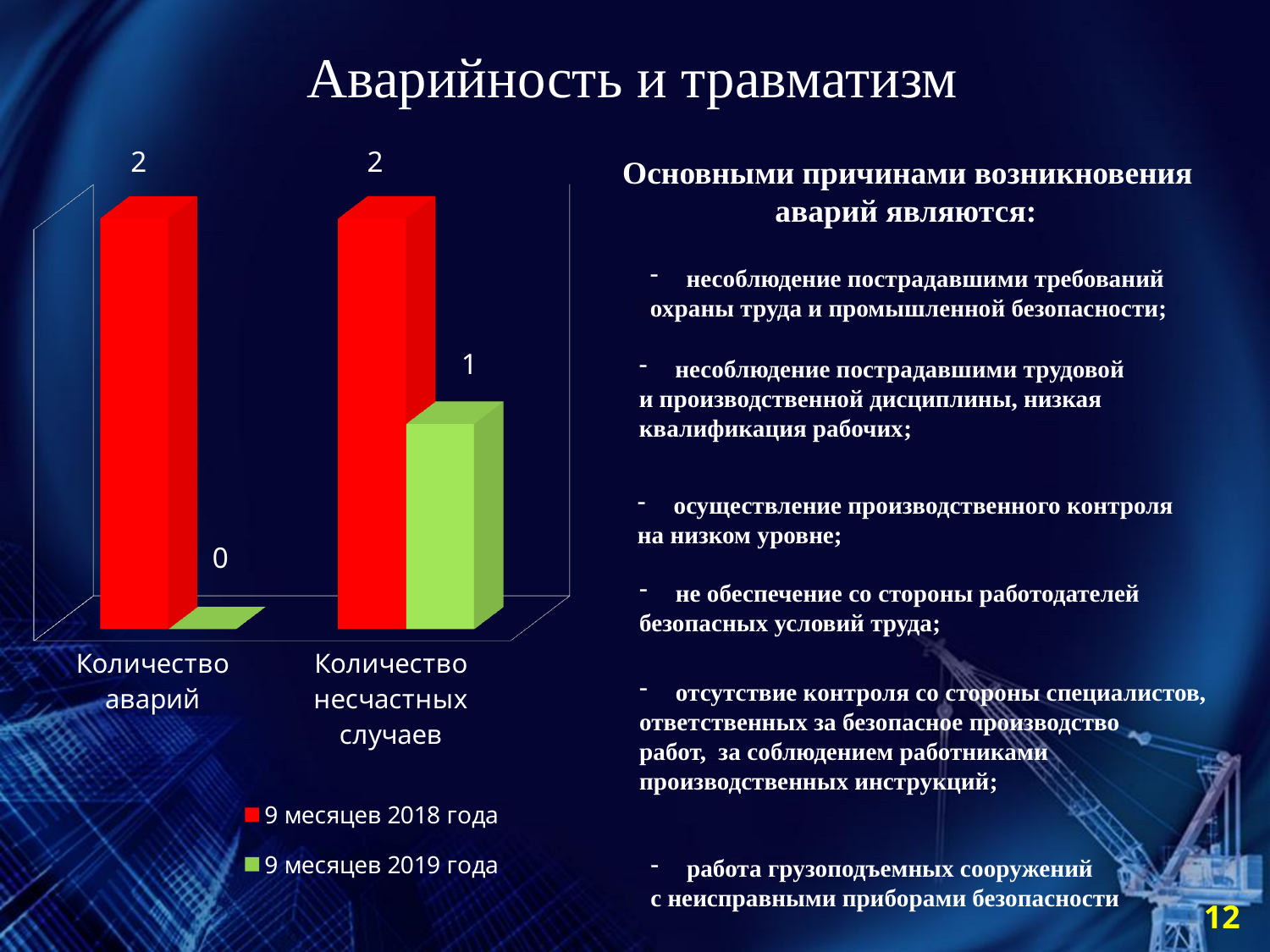
What is the value for "Количество несчастных случаев" in the "9 месяцев 2019 года" series? 1 Which colour represents the "9 месяцев 2019 года" series in the chart? Green What is the difference between the 2018 and 2019 values for "Количество несчастных случаев"? 1 What kind of chart is shown on the slide? Bar chart What is the difference between the 2018 and 2019 values for "Количество аварий"? 2 What is the value for "Количество аварий" in the "9 месяцев 2019 года" series? 0 What is the value for "Количество аварий" in the "9 месяцев 2018 года" series? 2 Which series has the larger value for "Количество несчастных случаев", "9 месяцев 2018 года" or "9 месяцев 2019 года"? 9 месяцев 2018 года How many series does the chart legend list? 2 What is the value for "Количество несчастных случаев" in the "9 месяцев 2018 года" series? 2 Which category has the lowest value in the "9 месяцев 2019 года" series? Количество аварий How many categories are shown on the x axis of the chart? 2